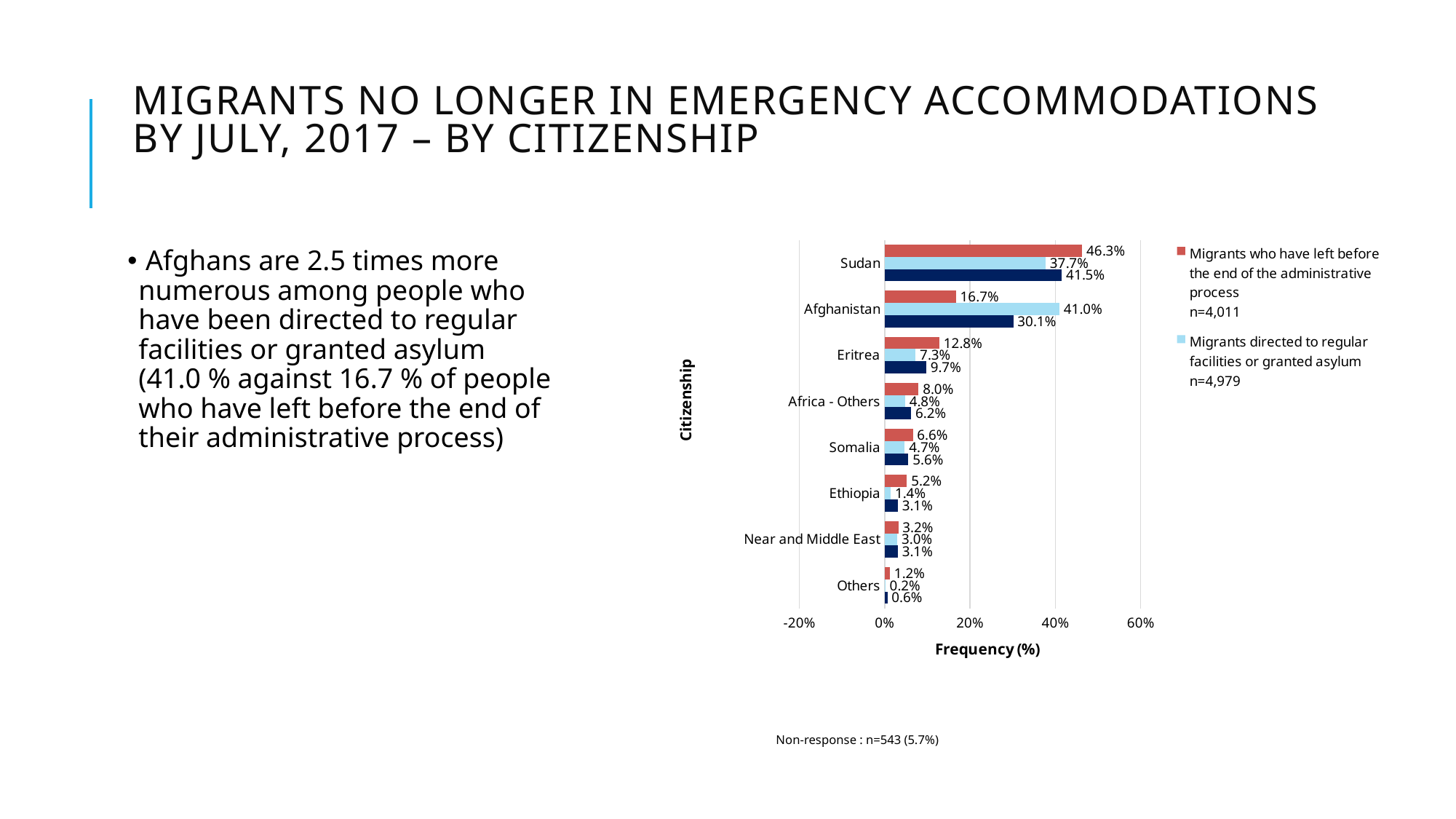
For Sudan, which series has the larger value: 'Migrants who have left before the end of the administrative process' or 'Migrants directed to regular facilities or granted asylum'? Migrants who have left before the end of the administrative process How many citizenship categories are shown on the chart? 8 What is the difference between the Afghanistan values for 'Migrants directed to regular facilities or granted asylum' and 'Migrants who have left before the end of the administrative process'? 24.3% What is the value for Afghanistan in the series 'Migrants directed to regular facilities or granted asylum'? 41.0% Which citizenship has the highest value in the series 'Migrants who have left before the end of the administrative process'? Sudan How many series does the chart's legend list? 2 What is the value for Sudan in the series 'Migrants who have left before the end of the administrative process'? 46.3% What kind of chart is shown on the slide? Bar chart Which citizenship has the lowest value in the series 'Migrants directed to regular facilities or granted asylum'? Others What is the label of the x axis of the chart? Frequency (%) What is the value for Eritrea in the series 'Migrants who have left before the end of the administrative process'? 12.8% What is the value for Ethiopia in the series 'Migrants directed to regular facilities or granted asylum'? 1.4%